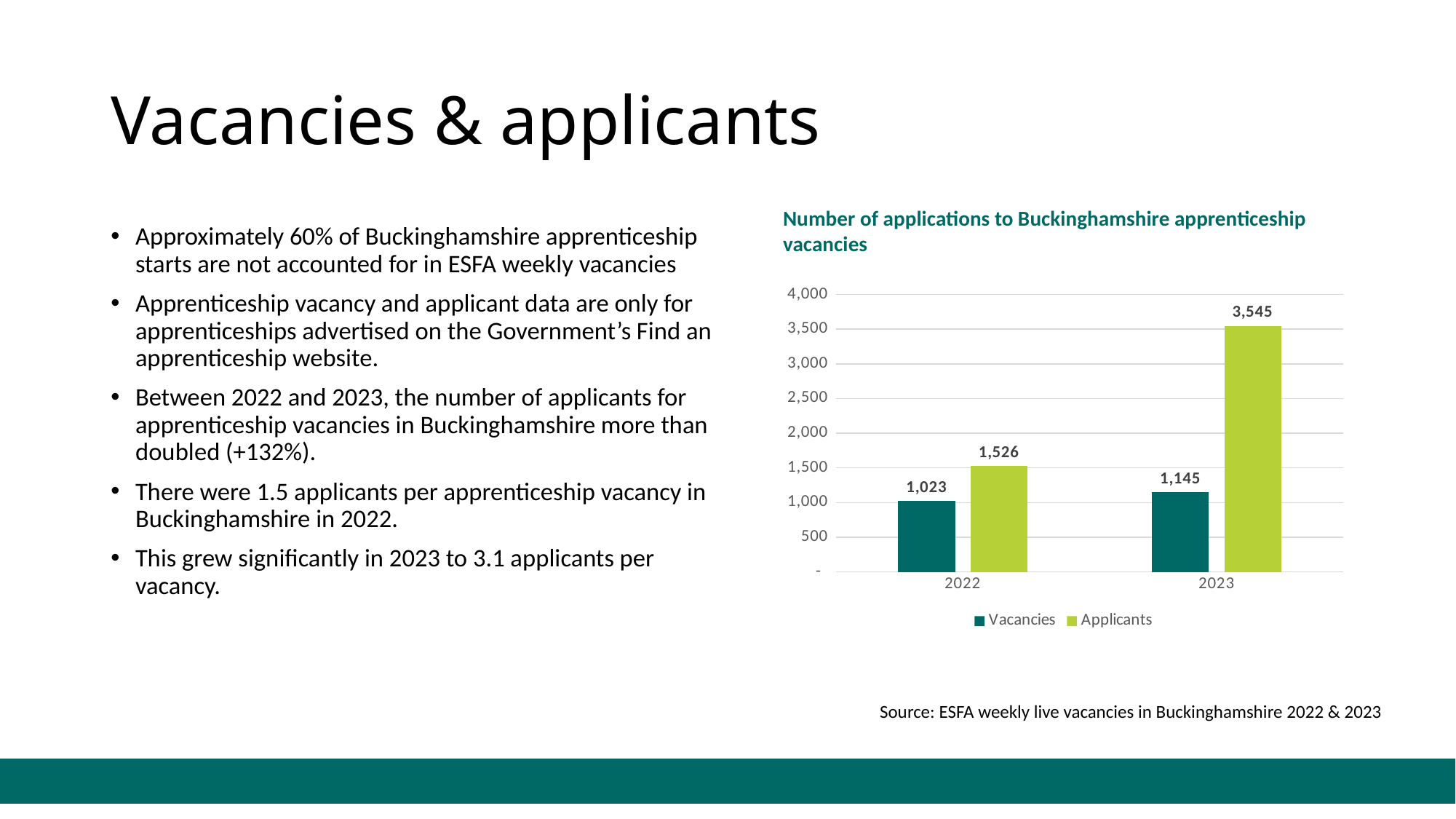
What is the difference between Applicants in 2023 and Applicants in 2022? 2,019 What is the title of the chart? Number of applications to Buckinghamshire apprenticeship vacancies Is the value for Applicants in 2023 greater or less than 3,000? greater What kind of chart is shown on the slide? Bar chart Which year has the higher number of Applicants? 2023 In 2022, which is larger: Vacancies or Applicants? Applicants What is the number of Vacancies in 2022? 1,023 What is the number of Applicants in 2023? 3,545 What is the number of Applicants in 2022? 1,526 What is the number of Vacancies in 2023? 1,145 How many series does the legend list? 2 What is the difference between Vacancies in 2023 and Vacancies in 2022? 122